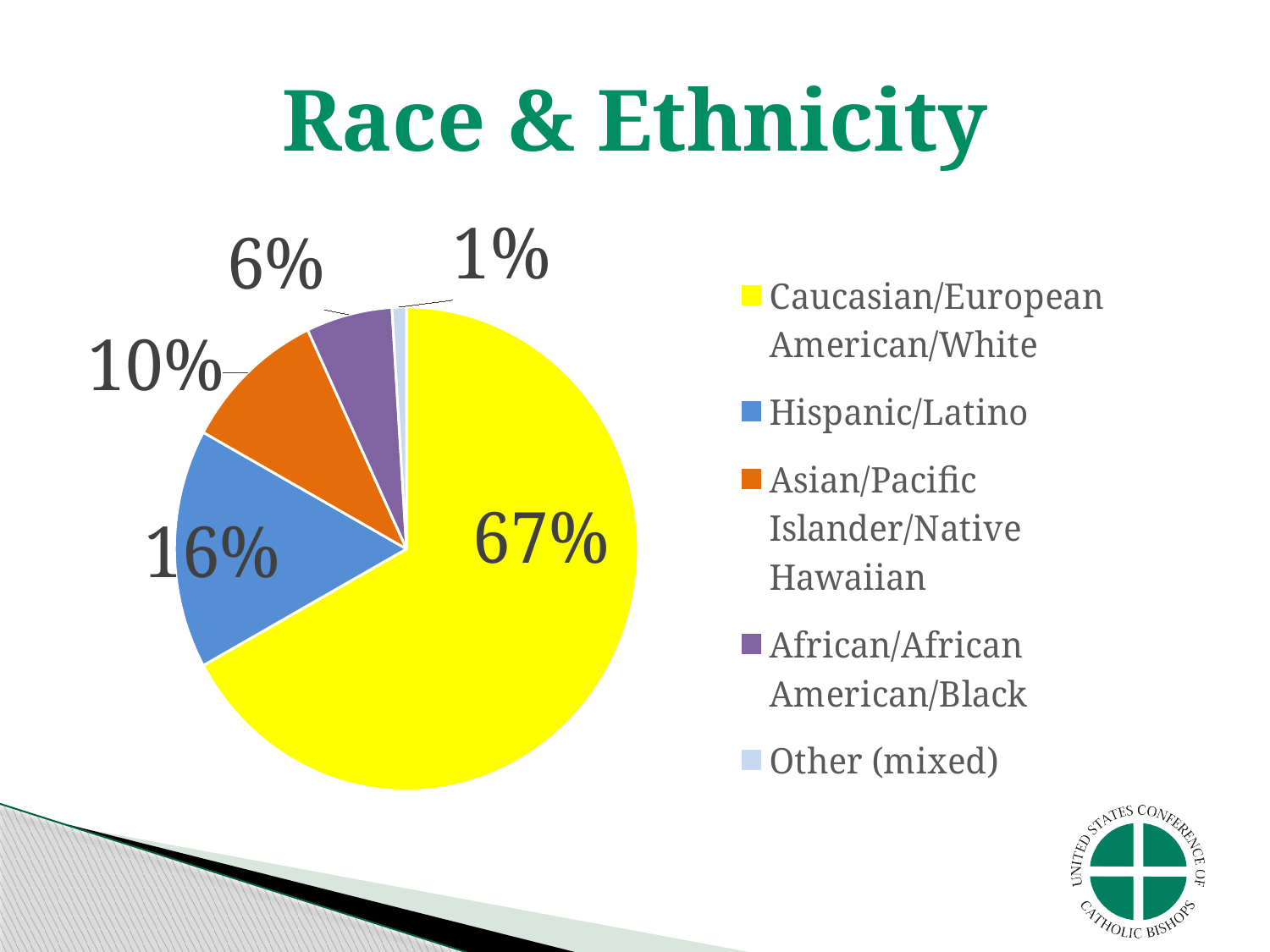
What is the title of the slide containing the pie chart? Race & Ethnicity What share of the pie is African/African American/Black? 6% Which category has the largest slice of the pie? Caucasian/European American/White What share of the pie is Caucasian/European American/White? 67% What share of the pie is Asian/Pacific Islander/Native Hawaiian? 10% What is the difference in percentage points between the Hispanic/Latino slice and the Asian/Pacific Islander/Native Hawaiian slice? 6% What kind of chart is shown on the slide? pie chart Which category has the smallest slice of the pie? Other (mixed) Which is larger, the Hispanic/Latino slice or the African/African American/Black slice? Hispanic/Latino How many categories does the legend list? 5